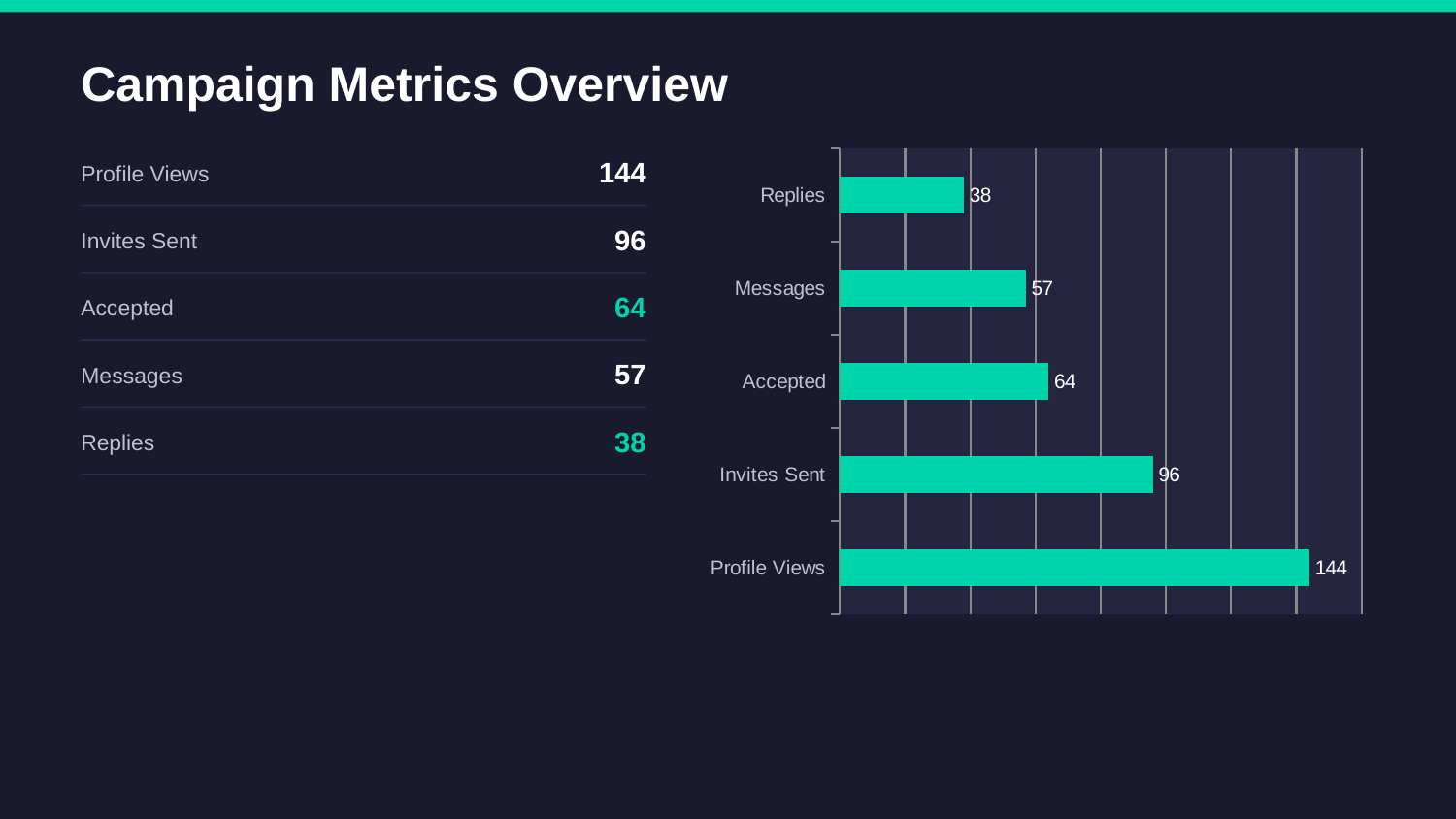
What is the difference between Invites Sent and Accepted? 32 Which category has the highest value in the chart? Profile Views Which category has the lowest value in the chart? Replies What is the title of the slide containing the chart? Campaign Metrics Overview What is the value for Messages in the chart? 57 How many categories are shown in the chart? 5 What is the value for Profile Views in the chart? 144 What is the difference between Profile Views and Invites Sent? 48 What kind of chart is shown on the slide? Bar chart What is the value for Replies in the chart? 38 What colour are the bars in the chart? Teal/green Which is larger, Accepted or Messages? Accepted